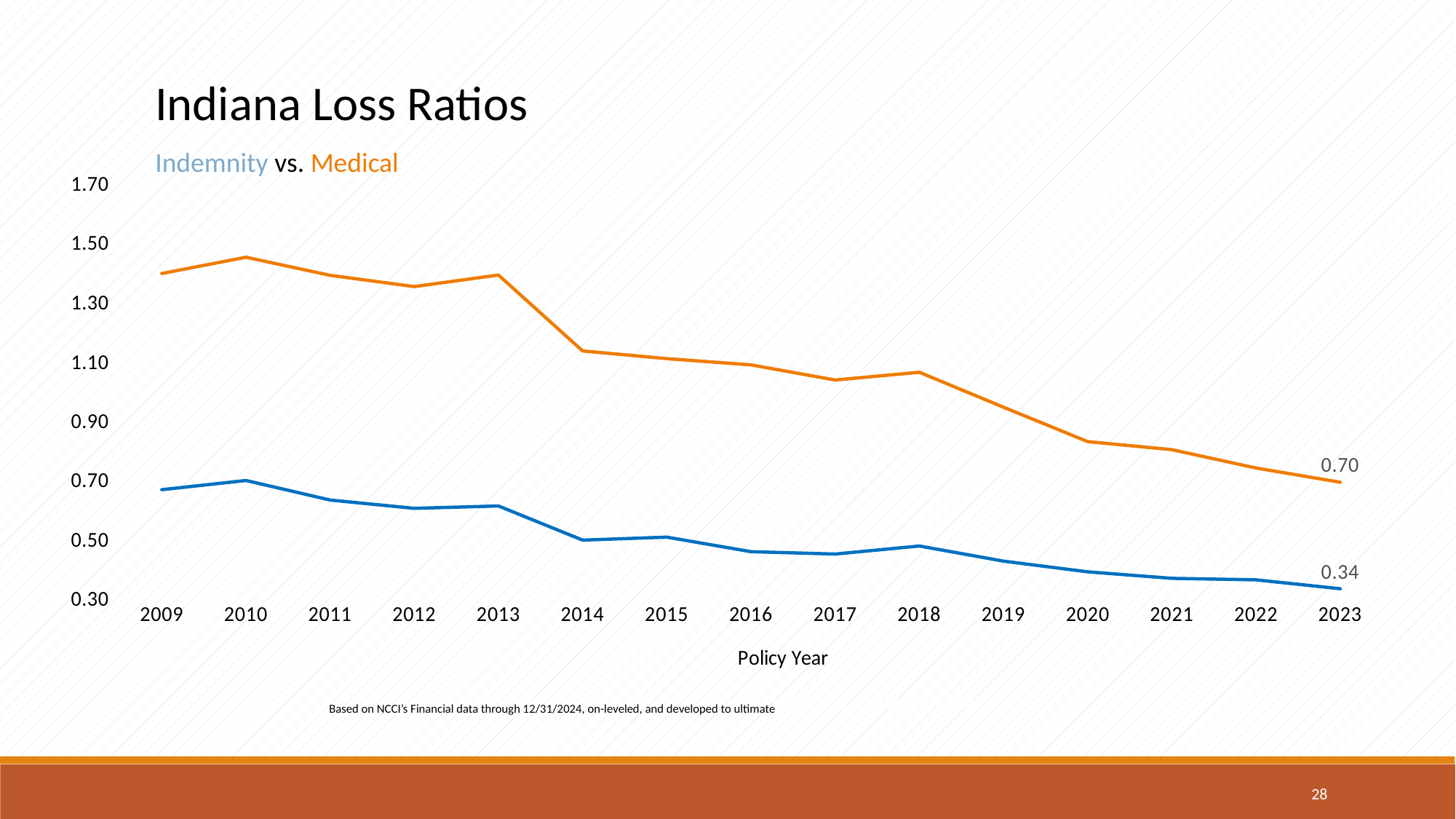
How many policy years are plotted on the x axis? 15 What kind of chart is shown on the slide? Line chart How many series does the chart show? 2 Is the Medical loss ratio for 2010 greater or less than 1.30? greater What is the title of the x axis? Policy Year Is the Indemnity loss ratio for 2014 greater or less than 0.70? less What is the Medical loss ratio for policy year 2023? 0.70 What is the Indemnity loss ratio for policy year 2023? 0.34 What is the difference between the Medical and Indemnity loss ratios in 2023? 0.36 In which policy year is the Medical loss ratio highest? 2010 In 2023, which series has the higher loss ratio, Indemnity or Medical? Medical Does the Medical loss ratio generally rise or fall from 2009 to 2023? Fall